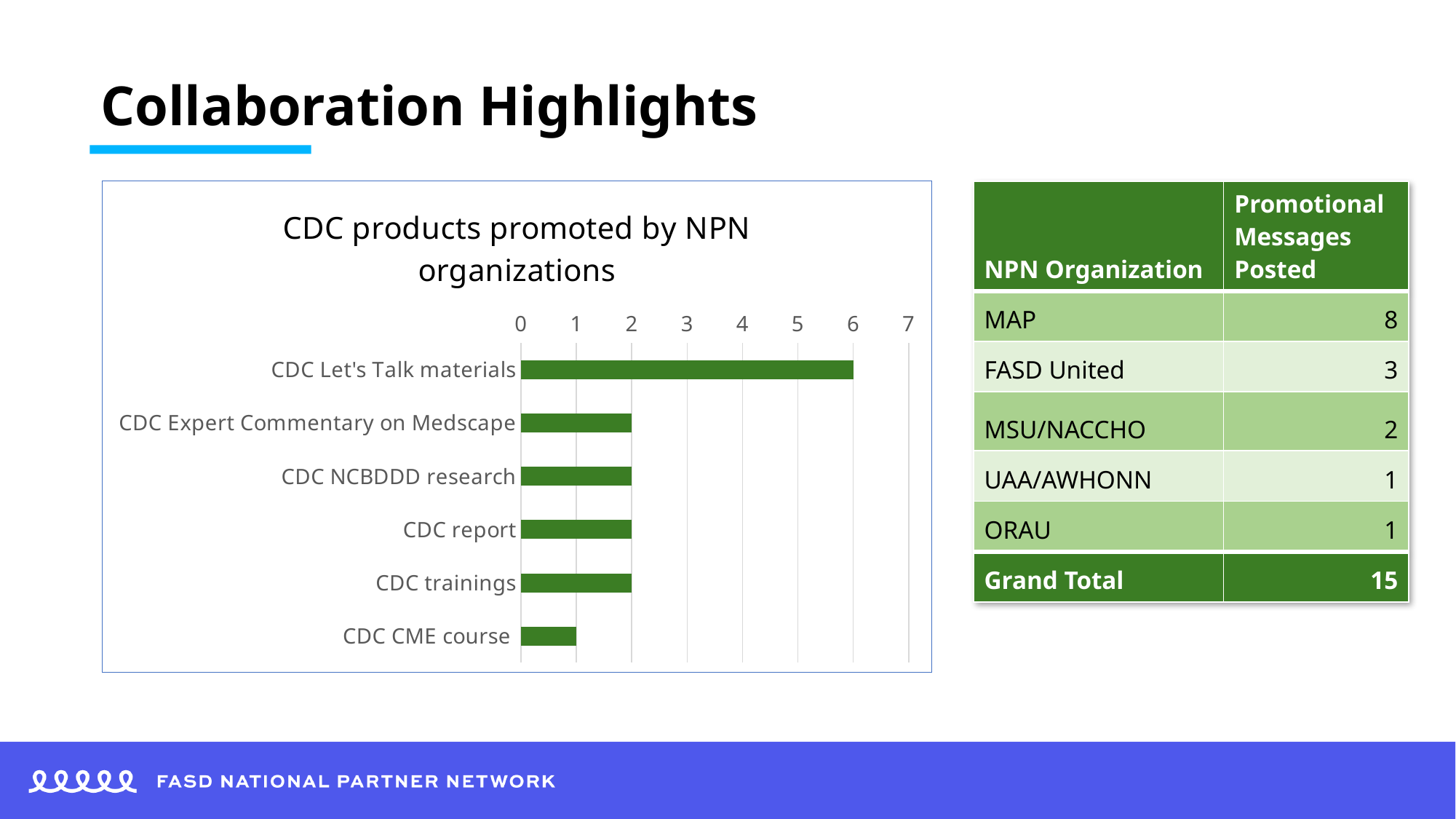
What type of chart is shown on the slide? bar chart Which is larger, the value for CDC trainings or the value for CDC CME course? CDC trainings What is the value for CDC NCBDDD research? 2 What is the highest value shown on the chart's axis? 7 What is the value for CDC CME course? 1 How many CDC products are listed as categories in the chart? 6 What is the value for CDC Let's Talk materials? 6 Which CDC product has the highest value in the chart? CDC Let's Talk materials What is the difference between the values for CDC Let's Talk materials and CDC CME course? 5 Is the value for CDC Let's Talk materials greater or less than 5? greater What is the title of the chart? CDC products promoted by NPN organizations Which CDC product has the lowest value in the chart? CDC CME course